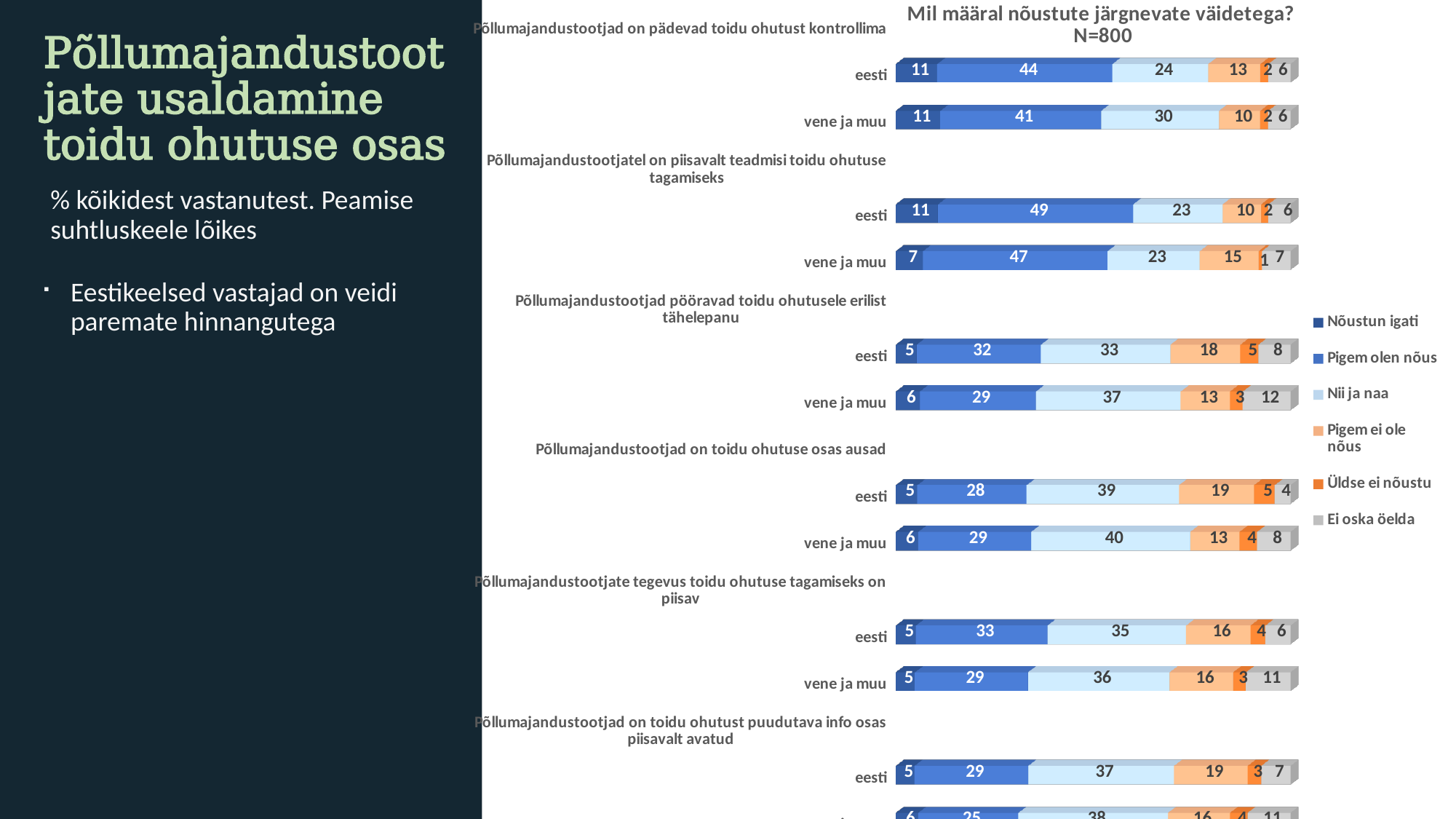
How many series does the chart legend list? 6 What is the 'Nõustun igati' value for 'vene ja muu' under the statement 'Põllumajandustootjatel on piisavalt teadmisi toidu ohutuse tagamiseks'? 7 What is the 'Nii ja naa' value for 'vene ja muu' under the statement 'Põllumajandustootjad on toidu ohutuse osas ausad'? 40 What is the 'Pigem olen nõus' value for 'eesti' under the statement 'Põllumajandustootjatel on piisavalt teadmisi toidu ohutuse tagamiseks'? 49 Which bar has the highest 'Pigem olen nõus' value? eesti, Põllumajandustootjatel on piisavalt teadmisi toidu ohutuse tagamiseks Which legend entry is shown in grey? Ei oska öelda What is the difference between the 'Nii ja naa' values for 'vene ja muu' and 'eesti' under the statement 'Põllumajandustootjad on pädevad toidu ohutust kontrollima'? 6 What sample size (N) is stated in the chart title? N=800 Under the statement 'Põllumajandustootjate tegevus toidu ohutuse tagamiseks on piisav', which group has the larger 'Ei oska öelda' value, 'eesti' or 'vene ja muu'? vene ja muu What is the 'Ei oska öelda' value for 'vene ja muu' under the statement 'Põllumajandustootjad pööravad toidu ohutusele erilist tähelepanu'? 12 What is the total of the 'eesti' bar under the statement 'Põllumajandustootjad on pädevad toidu ohutust kontrollima'? 100 What type of chart is shown on the slide? Stacked bar chart